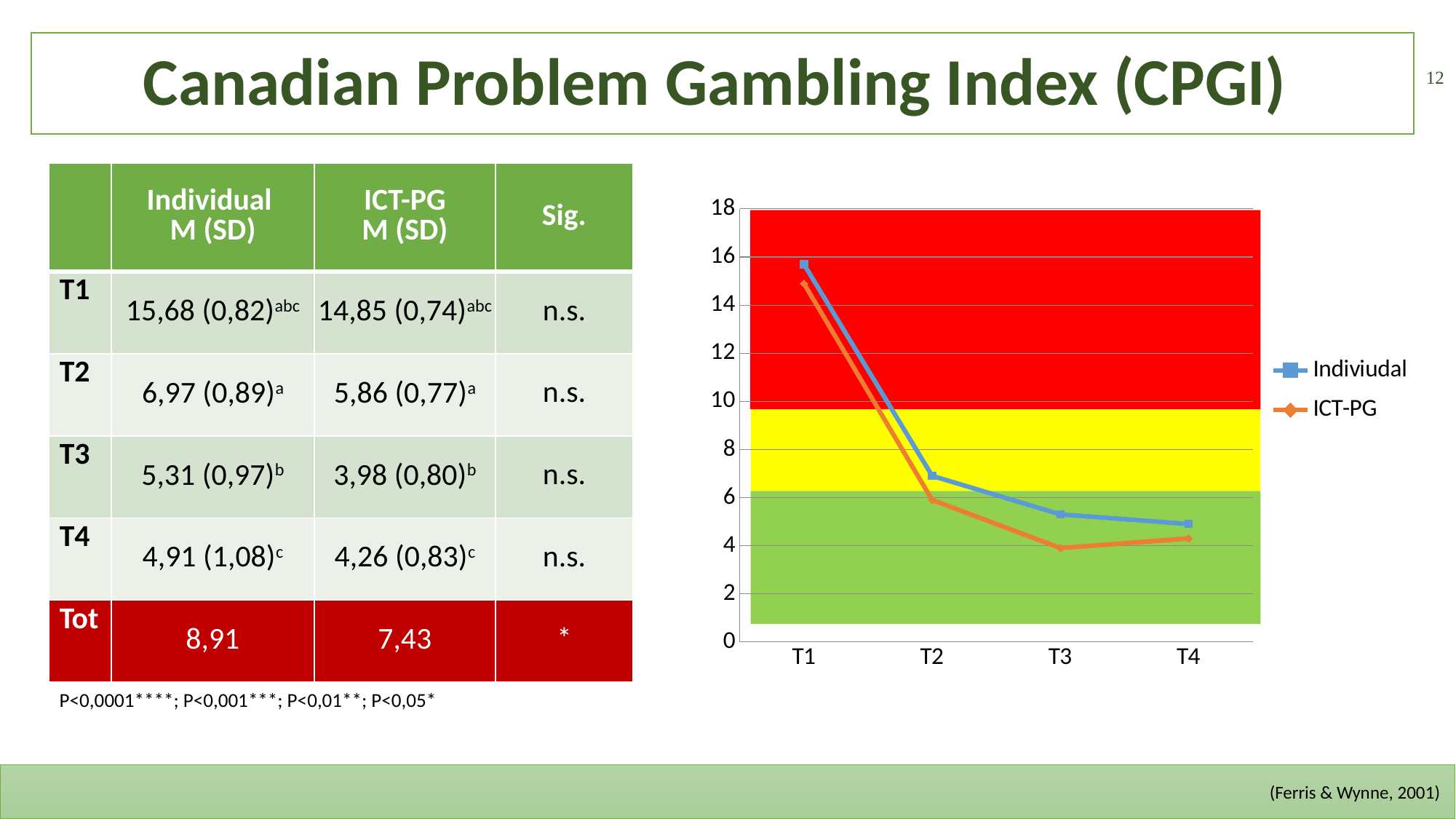
What colour is the ICT-PG line in the chart? orange Is the value for the Individual series at T1 greater or less than 14? greater Is the value for the ICT-PG series at T3 greater or less than 6? less How many time points are plotted along the x axis of the chart? 4 How many series does the chart's legend list? 2 At which time point is the ICT-PG series highest? T1 At T1, which series has the higher value, Individual or ICT-PG? Individual Do the values for the Individual series rise or fall from T1 to T4? fall Using the means printed in the table, what is the difference between the Individual and ICT-PG values at T1? 0,83 According to the table on the slide, what is the Individual mean at T2 that is plotted in the chart? 6,97 At which time point is the ICT-PG series lowest? T3 What kind of chart is shown on the slide? line chart